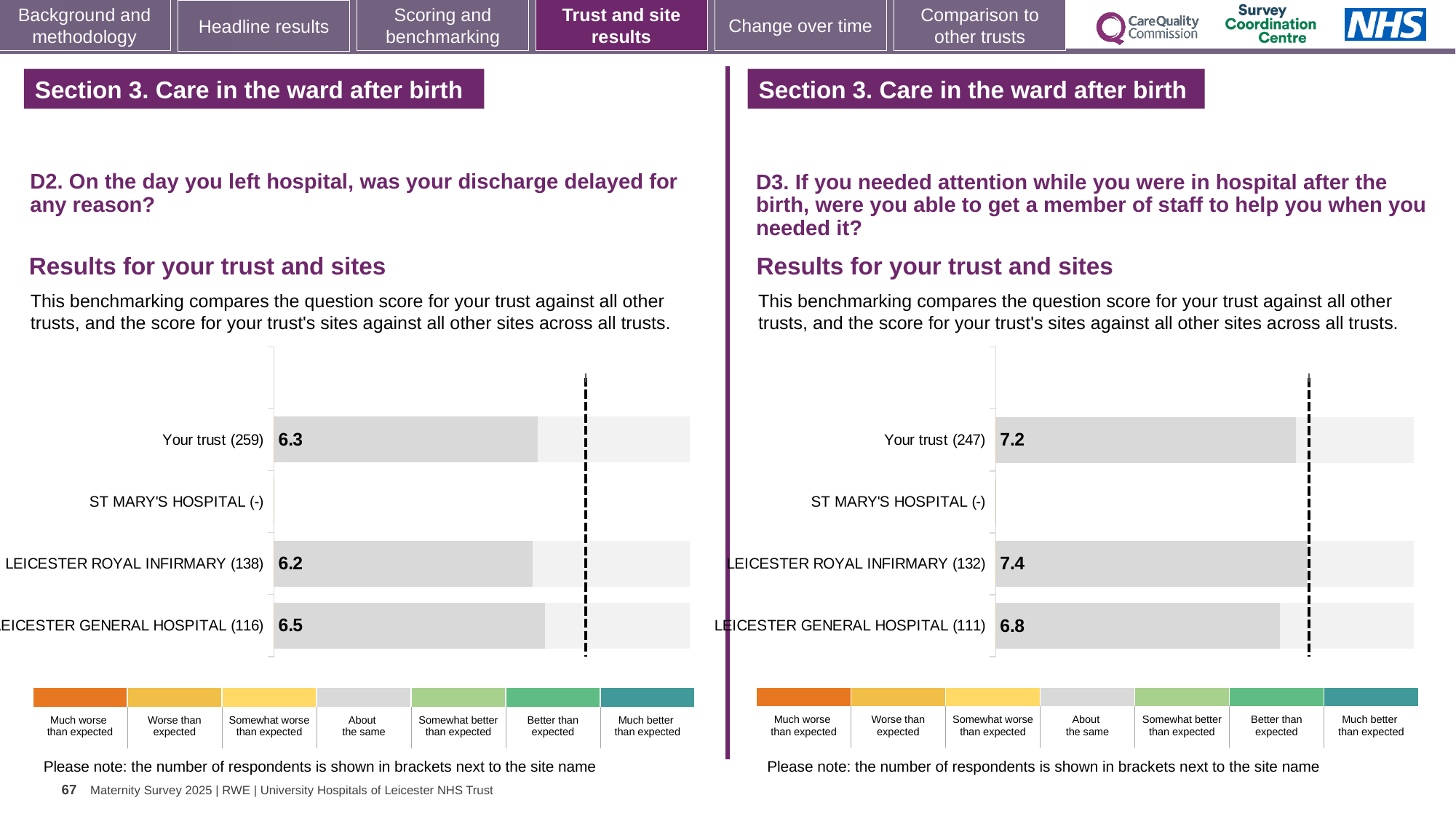
In the right chart (D3), how many respondents are shown in brackets for LEICESTER GENERAL HOSPITAL? 111 In the left chart (D2), what is the score for LEICESTER GENERAL HOSPITAL (116)? 6.5 In the left chart (D2), how many bars are plotted with a score? 3 In the right chart (D3), what is the score for LEICESTER ROYAL INFIRMARY (132)? 7.4 In the left chart (D2), which site or trust row has the lowest score? LEICESTER ROYAL INFIRMARY (138) What type of chart is used on the left (D2) to show the results for your trust and sites? Bar chart In the left chart (D2), what is the score for Your trust (259)? 6.3 In the right chart (D3), what is the score for Your trust (247)? 7.2 In the right chart (D3), what is the difference between the scores for LEICESTER ROYAL INFIRMARY (132) and LEICESTER GENERAL HOSPITAL (111)? 0.6 In the left chart (D2), what is the difference between the scores for LEICESTER GENERAL HOSPITAL (116) and LEICESTER ROYAL INFIRMARY (138)? 0.3 In the right chart (D3), which is larger: the score for Your trust (247) or for LEICESTER GENERAL HOSPITAL (111)? Your trust (247) In the right chart (D3), which site or trust row has the highest score? LEICESTER ROYAL INFIRMARY (132)